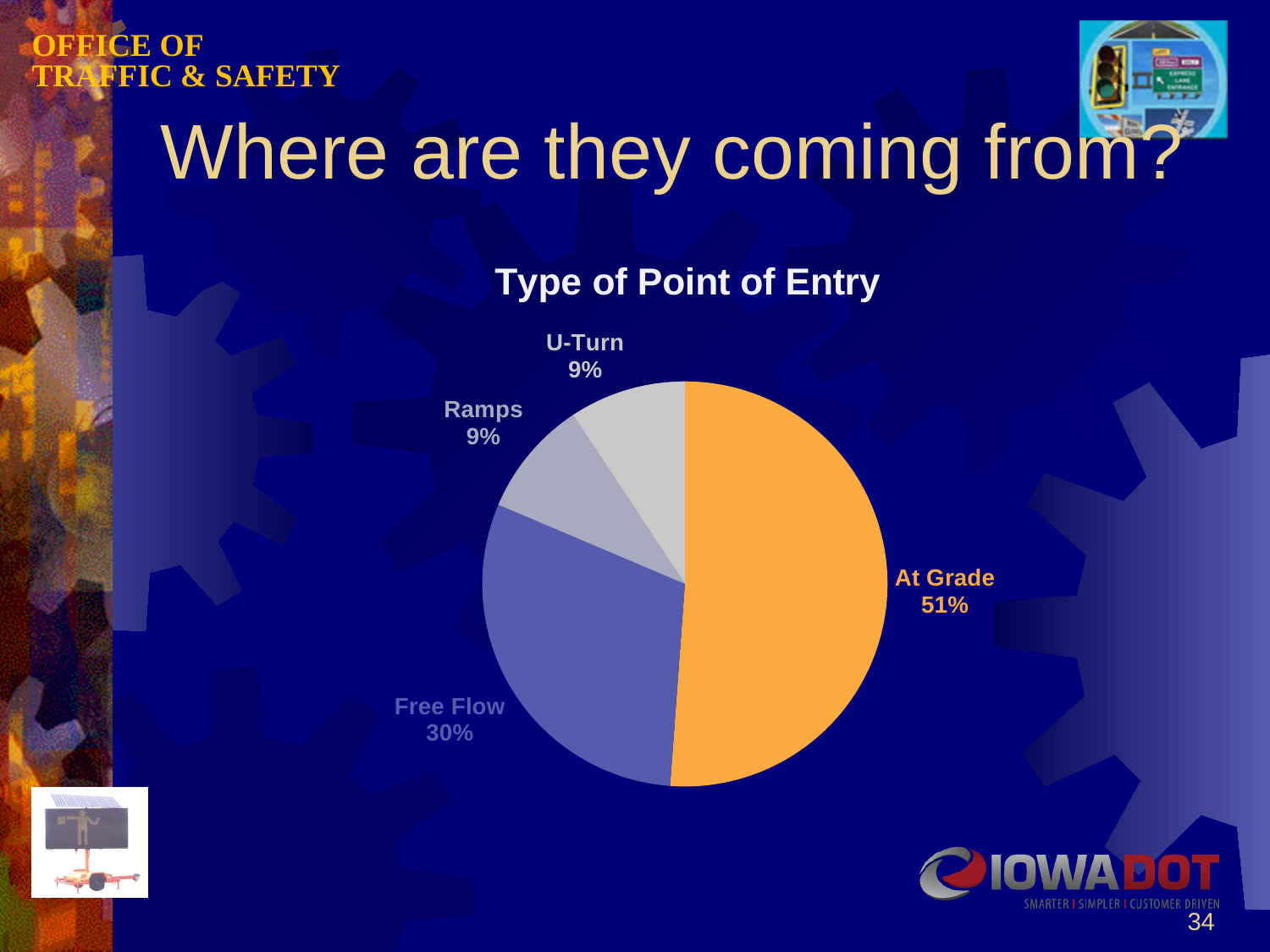
What is the difference between the At Grade and Free Flow shares? 21% What share of the pie does At Grade represent? 51% What is the combined share of Ramps and U-Turn? 18% What is the title of the chart? Type of Point of Entry Which category has the largest slice of the pie? At Grade How many categories are shown in the pie chart? 4 What is the value shown for U-Turn? 9% What colour is the At Grade slice? orange What type of chart is shown on the slide? pie chart What is the value shown for Ramps? 9% What share of the pie does Free Flow represent? 30% Which is larger, the Free Flow share or the Ramps share? Free Flow